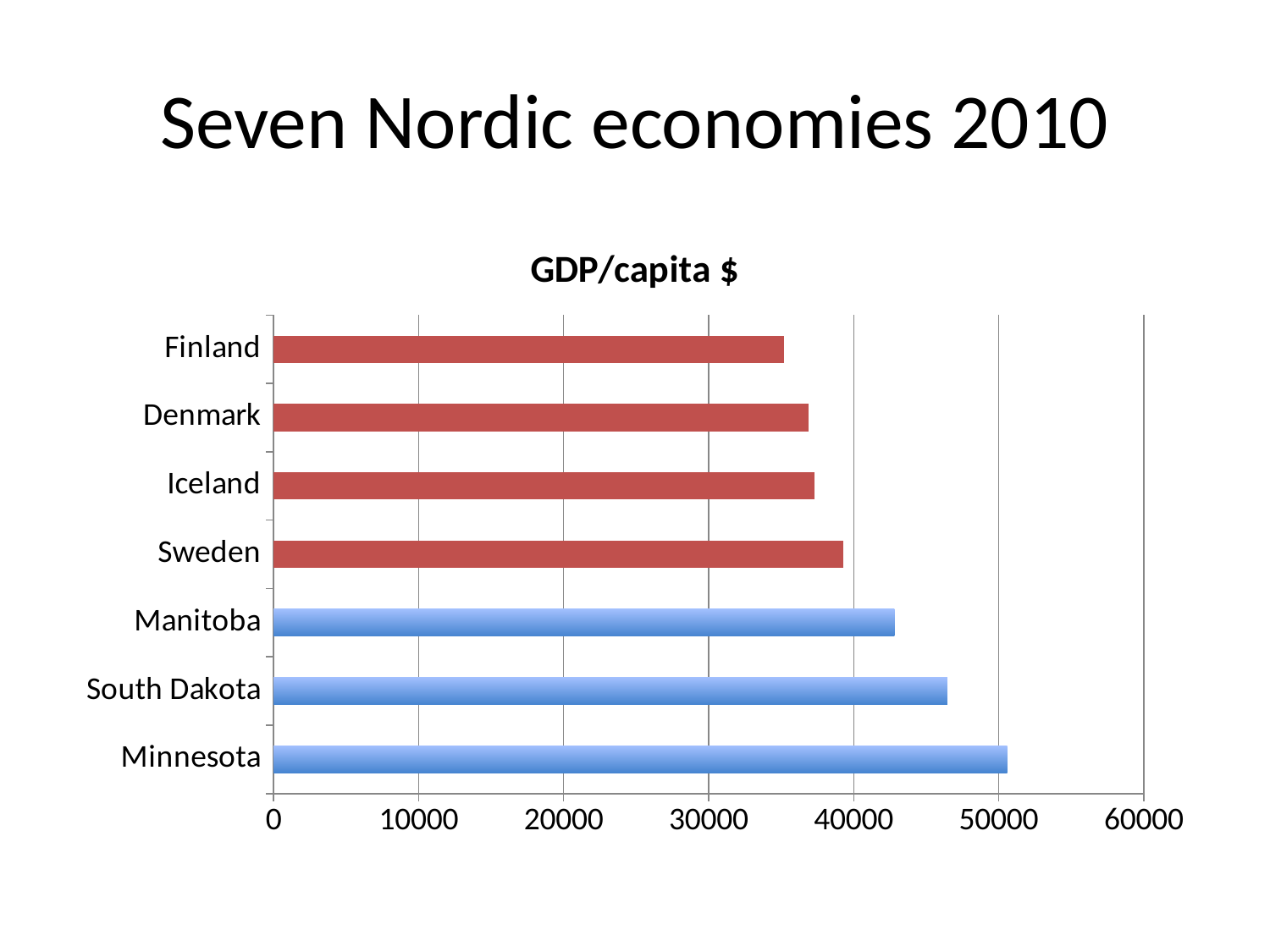
What is the title of the chart? GDP/capita $ Is the GDP/capita $ value for Denmark greater or less than 40000? less Which category has the highest GDP/capita $? Minnesota Is the GDP/capita $ value for South Dakota greater or less than 40000? greater Which has a higher GDP/capita $, South Dakota or Manitoba? South Dakota What kind of chart is shown on the slide? bar chart Is the GDP/capita $ value for Iceland greater or less than 40000? less How many categories are plotted in the GDP/capita $ chart? 7 Which category has the lowest GDP/capita $? Finland Which has a higher GDP/capita $, Manitoba or Sweden? Manitoba